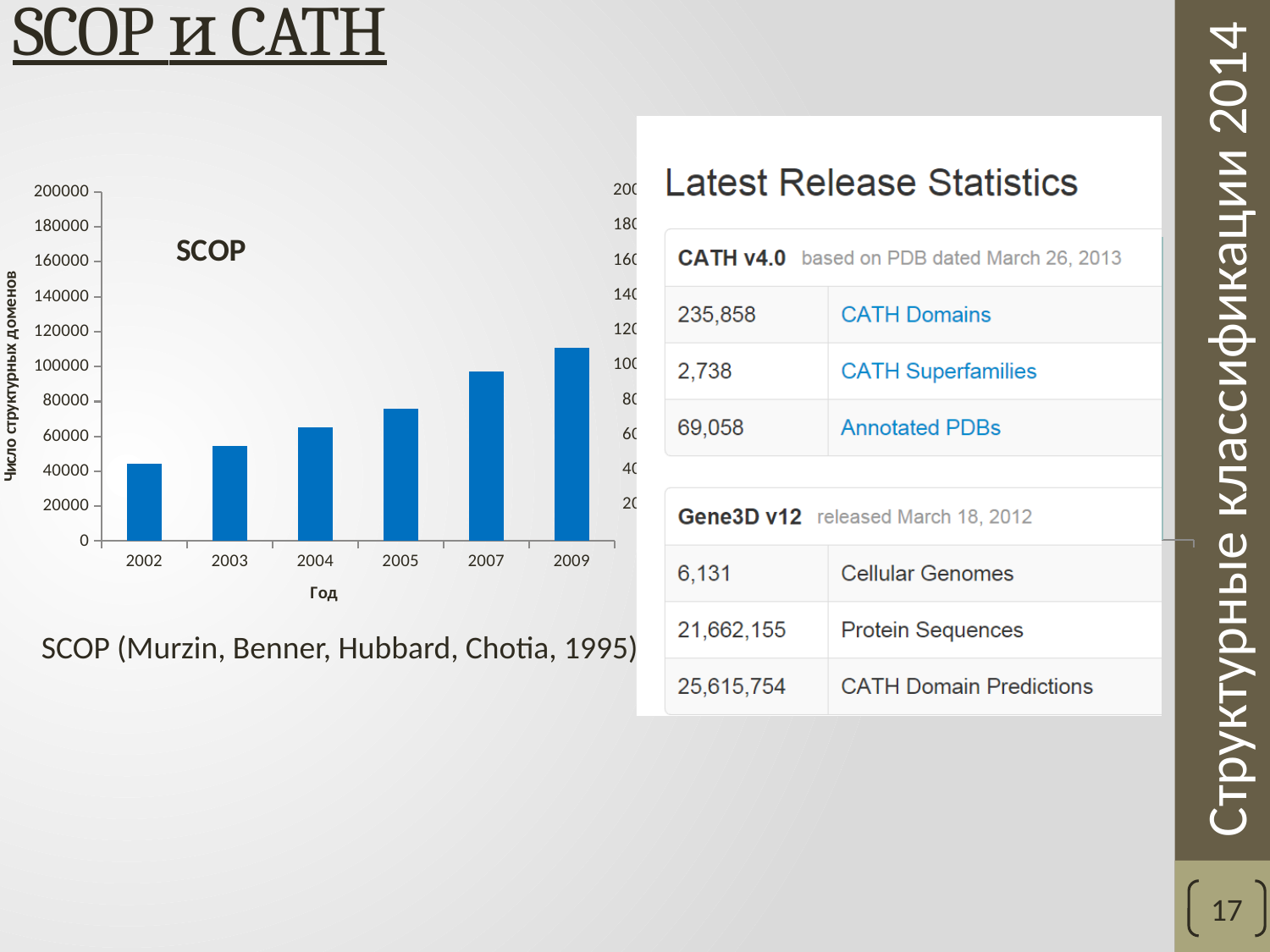
What kind of chart is the SCOP chart on the slide? bar chart In the SCOP chart, which year has the larger value, 2003 or 2007? 2007 What is the x-axis label of the SCOP chart? Год In the SCOP chart, is the value for 2009 greater or less than 100000? greater In the SCOP chart, is the value for 2003 greater or less than 60000? less In the SCOP chart, which year has the highest number of structural domains? 2009 In the SCOP chart, is the value for 2002 greater or less than 60000? less How many years are shown on the x axis of the SCOP chart? 6 In the SCOP chart, do the values rise or fall from 2002 to 2009? rise In the SCOP chart, which year has the lowest number of structural domains? 2002 What is the title of the bar chart on the left of the slide? SCOP